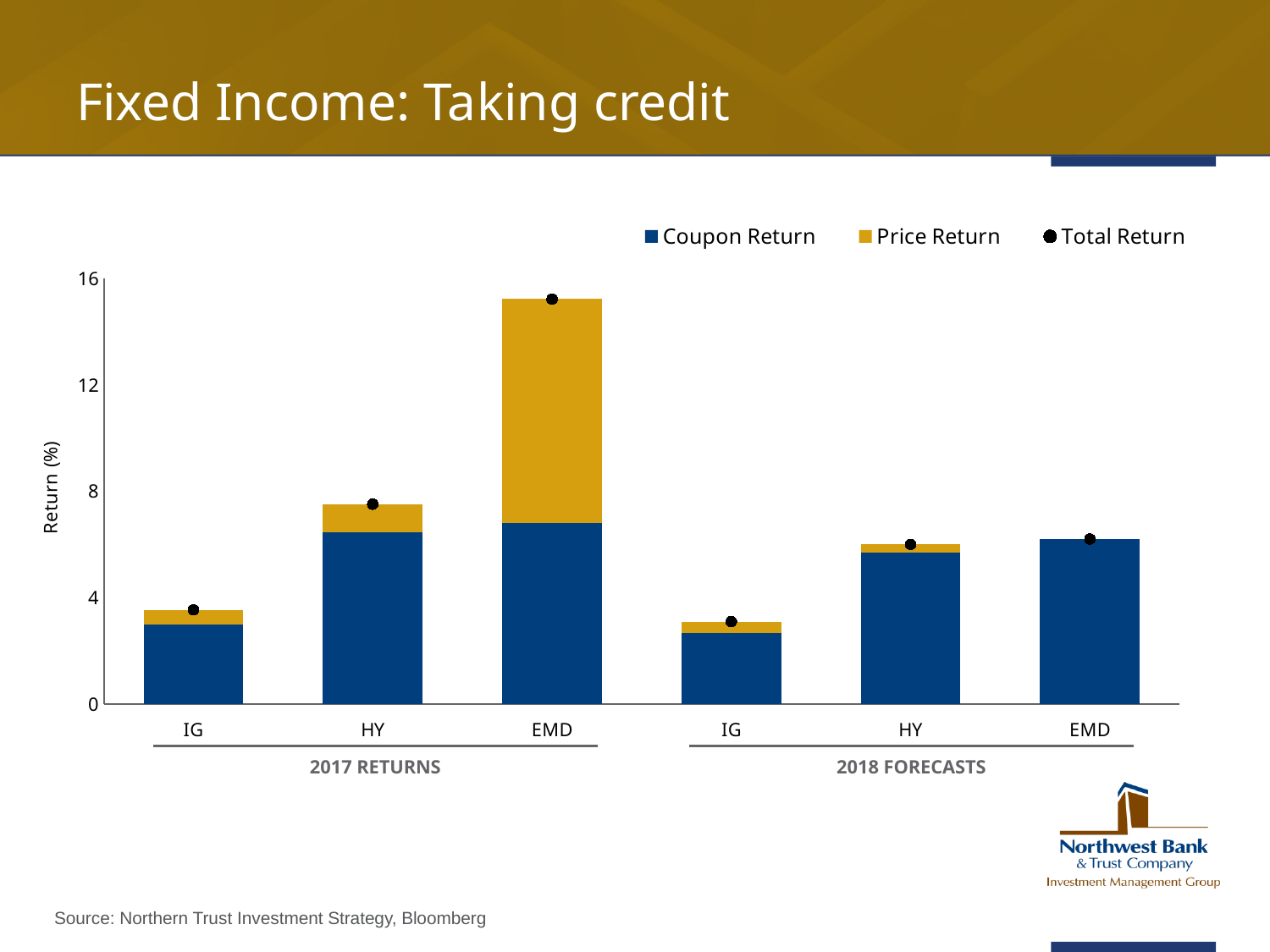
Which is larger, the total return for HY under 2017 Returns or HY under 2018 Forecasts? HY under 2017 Returns Is the total return for EMD under 2017 Returns greater or less than 12? greater Is the total return for HY under 2017 Returns greater or less than 8? less How many series does the legend list? 3 Is the total return for IG under 2017 Returns greater or less than 4? less Which is larger, the total return for EMD under 2017 Returns or EMD under 2018 Forecasts? EMD under 2017 Returns How many bars are plotted in the chart? 6 What is the label of the y axis? Return (%) What kind of chart is shown on the slide? bar chart Which category has the highest total return in the chart? EMD (2017 Returns)